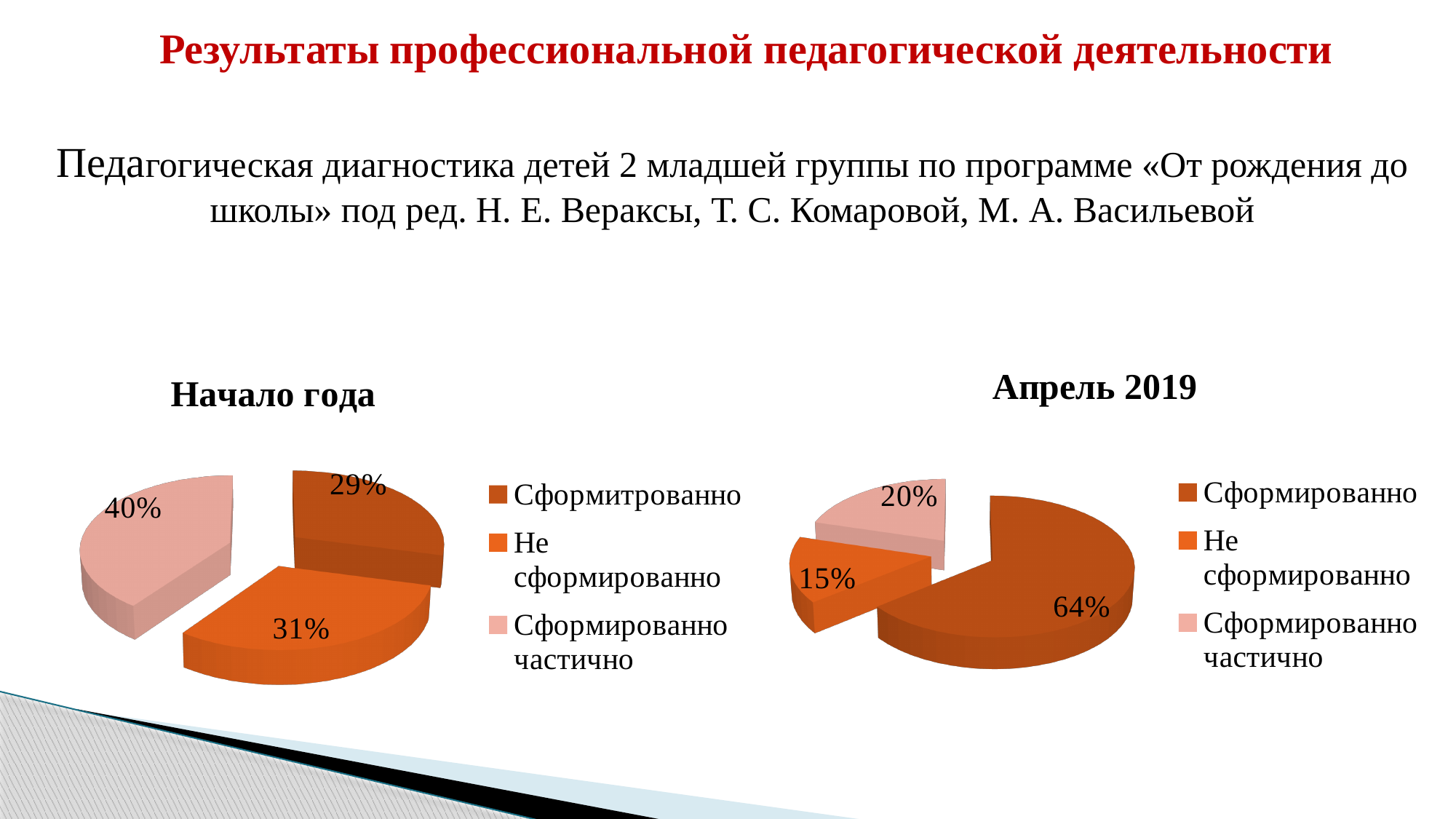
What type of chart is the "Начало года" chart? Pie chart In the "Апрель 2019" chart, which category has the smallest slice? Не сформированно How many entries does the legend of the "Апрель 2019" chart list? 3 In the "Начало года" chart, which category has the largest slice? Сформированно частично In the "Начало года" chart, what share is labelled for the "Не сформированно" slice? 31% How many slices does the "Апрель 2019" chart have? 3 In the "Начало года" chart, what share is labelled for the "Сформированно частично" slice? 40% In the "Апрель 2019" chart, what is the difference in percentage points between the "Сформированно" slice and the "Сформированно частично" slice? 44 In the "Начало года" chart, which is larger: the "Не сформированно" slice or the "Сформированно частично" slice? Сформированно частично What is the title of the chart on the right side of the slide? Апрель 2019 In the "Апрель 2019" chart, what share is labelled for the "Не сформированно" slice? 15% In the "Апрель 2019" chart, what share is labelled for the "Сформированно" slice? 64%